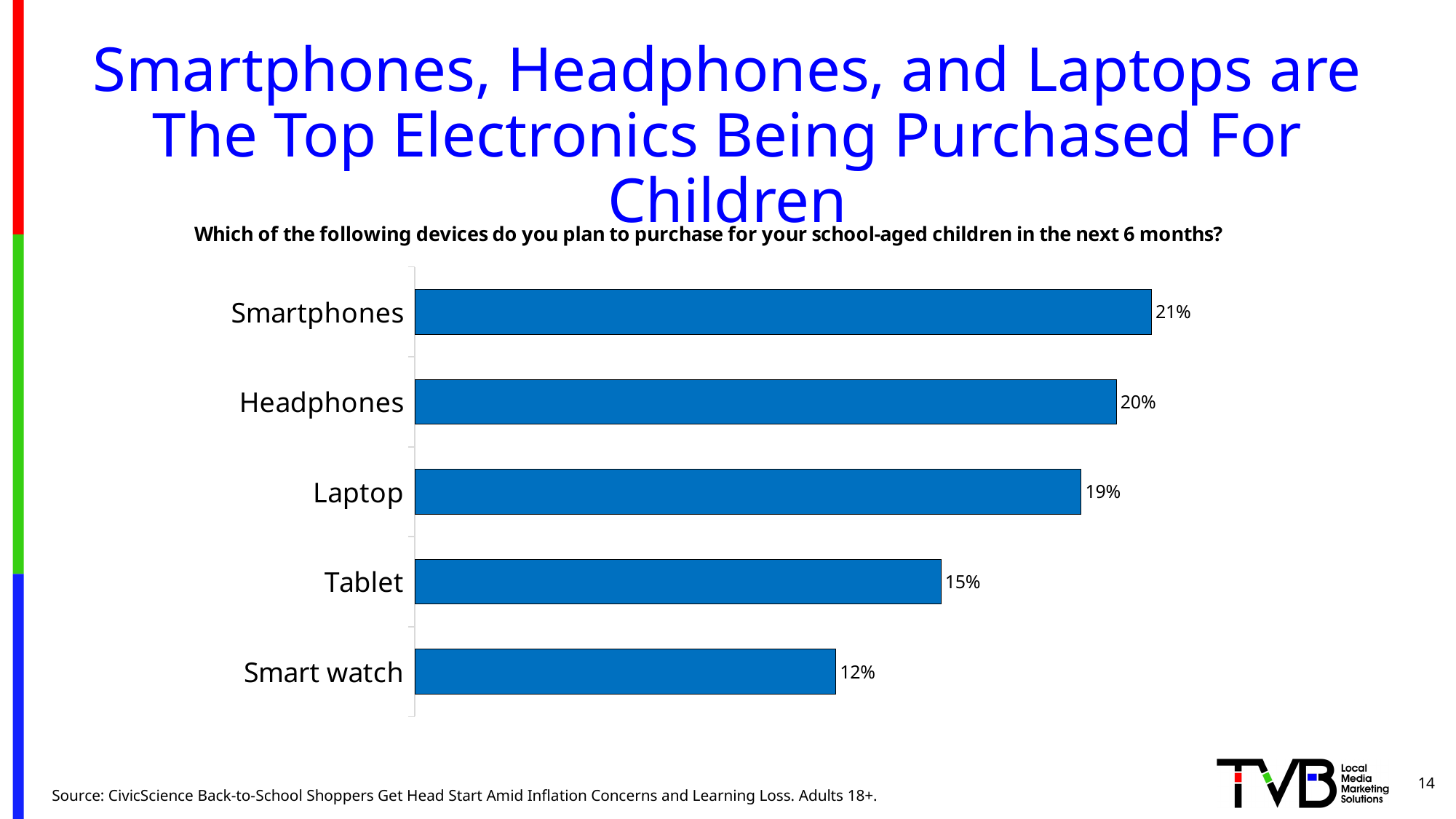
Which device has the lowest percentage? Smart watch What is the difference between the values for Laptop and Tablet? 4% Which has a larger value, Tablet or Smart watch? Tablet What survey question is shown above the chart? Which of the following devices do you plan to purchase for your school-aged children in the next 6 months? Which device has the highest percentage? Smartphones What is the value shown for Smart watch? 12% What percentage of respondents plan to purchase smartphones for their school-aged children? 21% What is the value shown for Tablet? 15% What type of chart is shown on the slide? Bar chart What is the value shown for Headphones? 20% How many devices are shown in the chart? 5 What is the difference between the values for Smartphones and Smart watch? 9%